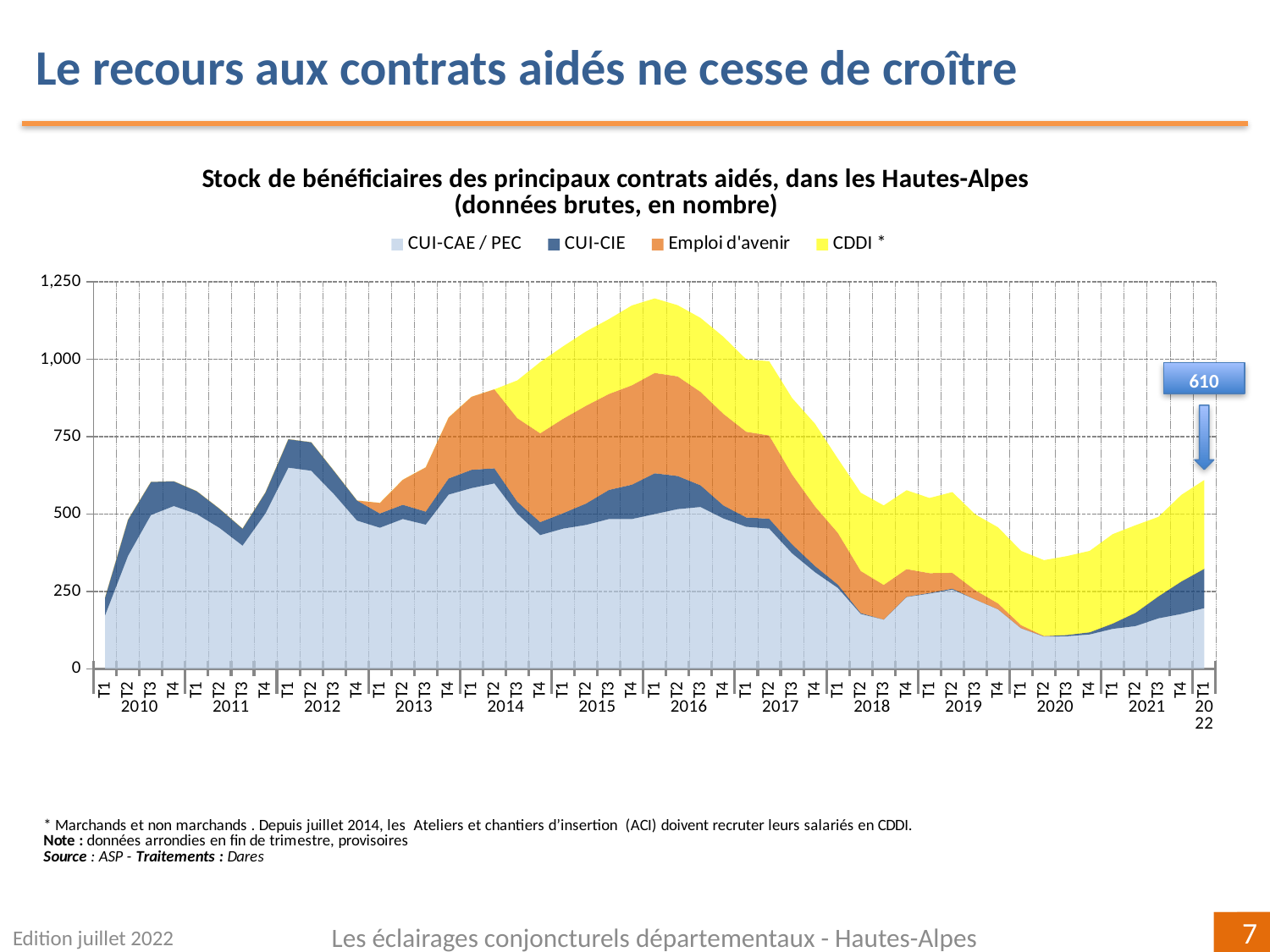
What is the total stock of beneficiaries labelled for T1 2022? 610 Is the total stock of beneficiaries at T1 2010 greater or less than 250? less How many years are labelled on the x axis? 13 Which series is shown in yellow in the legend? CDDI * Is the value for CUI-CAE / PEC at T1 2022 greater or less than 250? less Does the total stock of beneficiaries rise or fall between T1 2016 and T2 2020? fall What kind of chart is shown on the slide? Stacked area chart Does the total stock of beneficiaries rise or fall between T2 2020 and T1 2022? rise Is the total stock of beneficiaries at T1 2022 greater or less than 500? greater Which is larger, the total stock at T1 2016 or the total stock at T1 2019? T1 2016 How many series does the legend list? 4